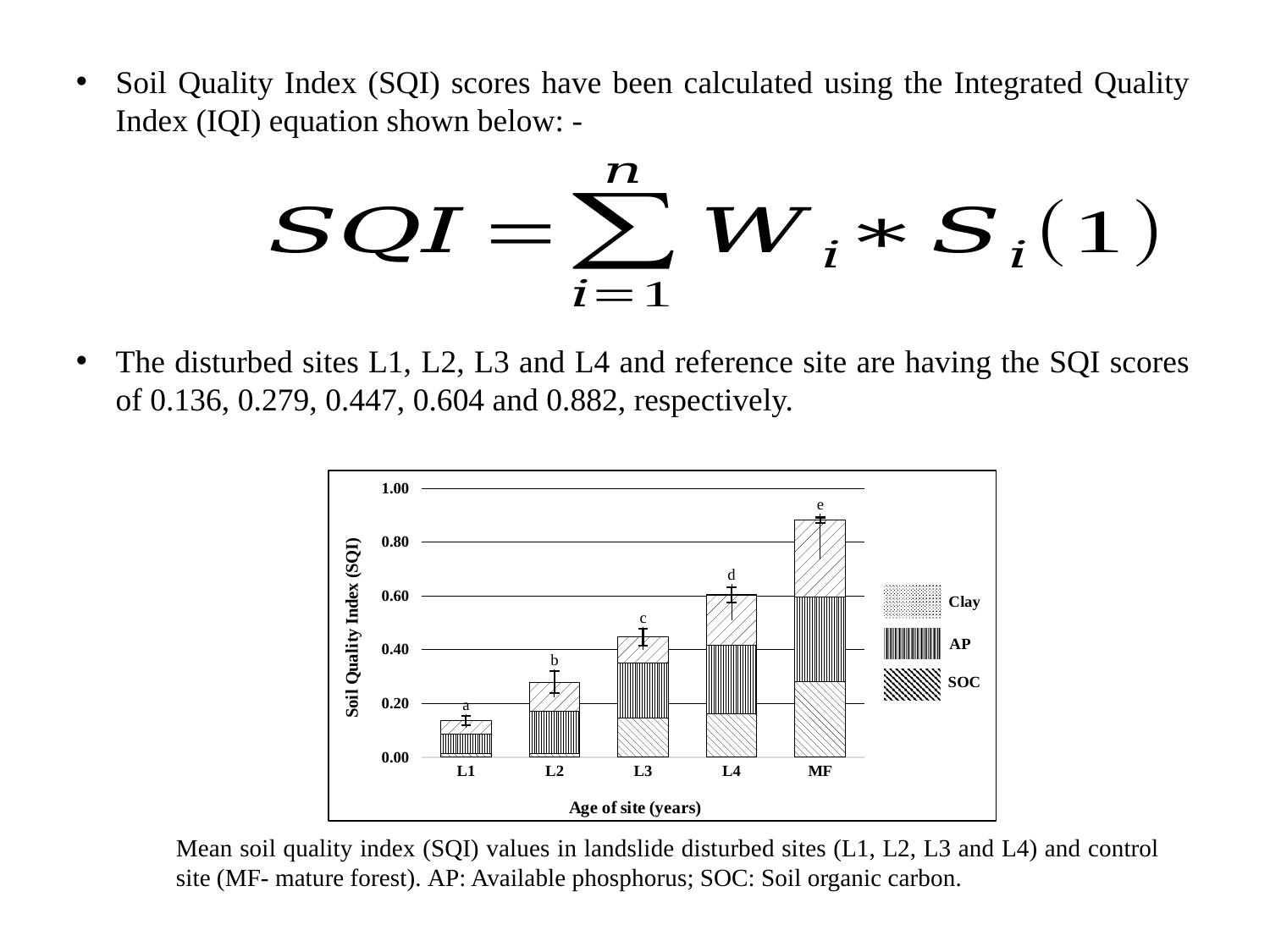
How many sites (categories) are shown on the x axis of the chart? 5 What are the three series listed in the chart's legend? Clay, AP, SOC Which site has the lowest total Soil Quality Index in the chart? L1 What is the title of the chart's y axis? Soil Quality Index (SQI) Which site has a larger total SQI, L2 or L3? L3 How many series does the chart's legend list? 3 Which site has the highest total Soil Quality Index in the chart? MF Do the total SQI values rise or fall moving from L1 to MF along the x axis? Rise Is the total SQI value for L4 greater or less than 0.40? greater Is the total SQI value for L1 greater or less than 0.20? less What kind of chart is shown on the slide? Stacked bar chart Is the total SQI value for MF greater or less than 0.80? greater